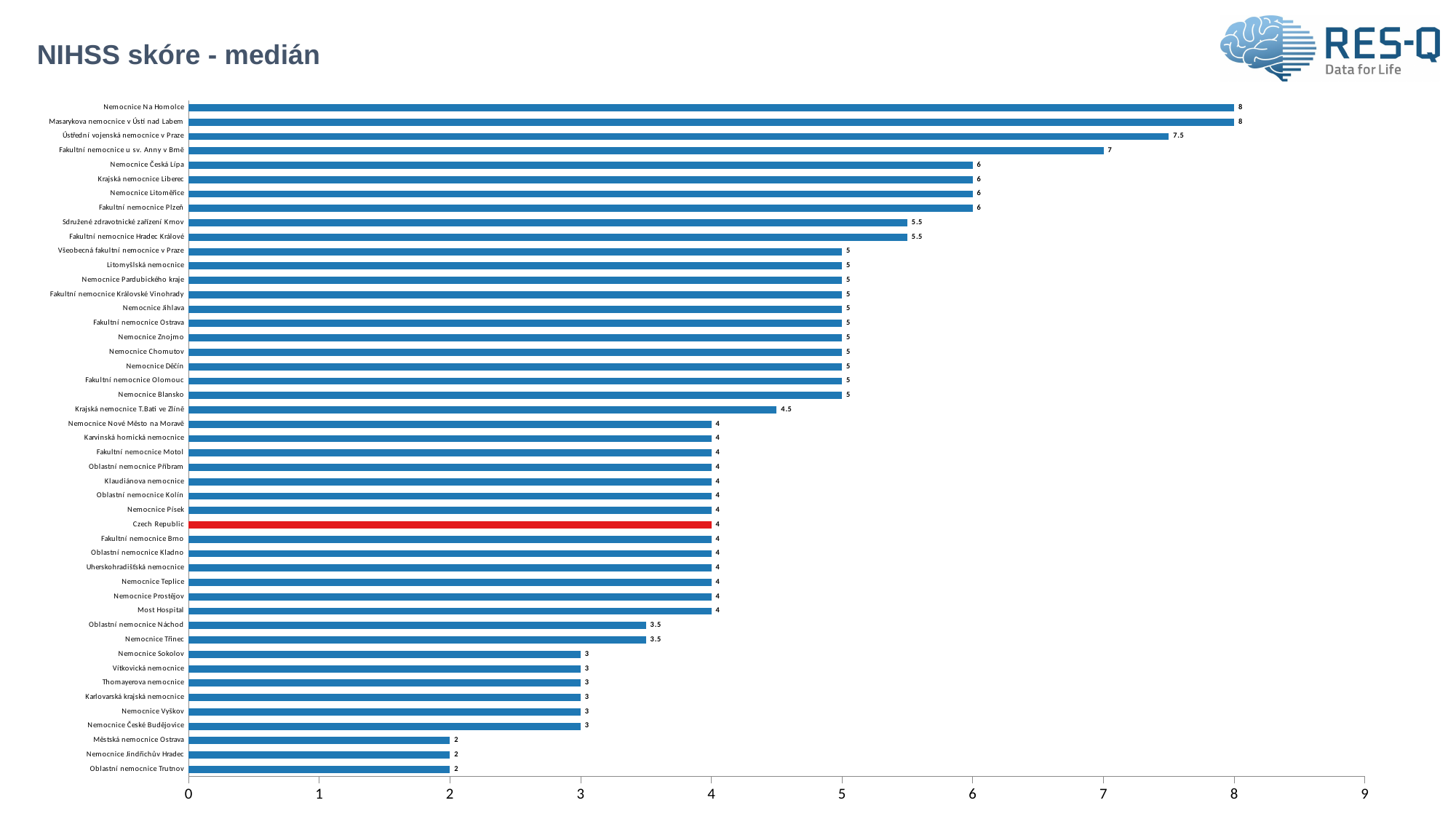
Which has a higher value, Fakultní nemocnice Plzeň or Fakultní nemocnice Motol? Fakultní nemocnice Plzeň What is the value shown for Oblastní nemocnice Trutnov? 2 What is the difference between the values for Nemocnice Na Homolce and Fakultní nemocnice u sv. Anny v Brně? 1 What is the value shown for Nemocnice Třinec? 3.5 Which has a lower value, Městská nemocnice Ostrava or Nemocnice Sokolov? Městská nemocnice Ostrava What is the value shown for Ústřední vojenská nemocnice v Praze? 7.5 What is the difference between the values for Sdružené zdravotnické zařízení Krnov and Czech Republic? 1.5 What type of chart is shown on the slide? bar chart What is the value shown for Krajská nemocnice T.Bati ve Zlíně? 4.5 What is the median NIHSS score for Czech Republic? 4 What is the title of the chart? NIHSS skóre - medián Which bar is highlighted in red? Czech Republic